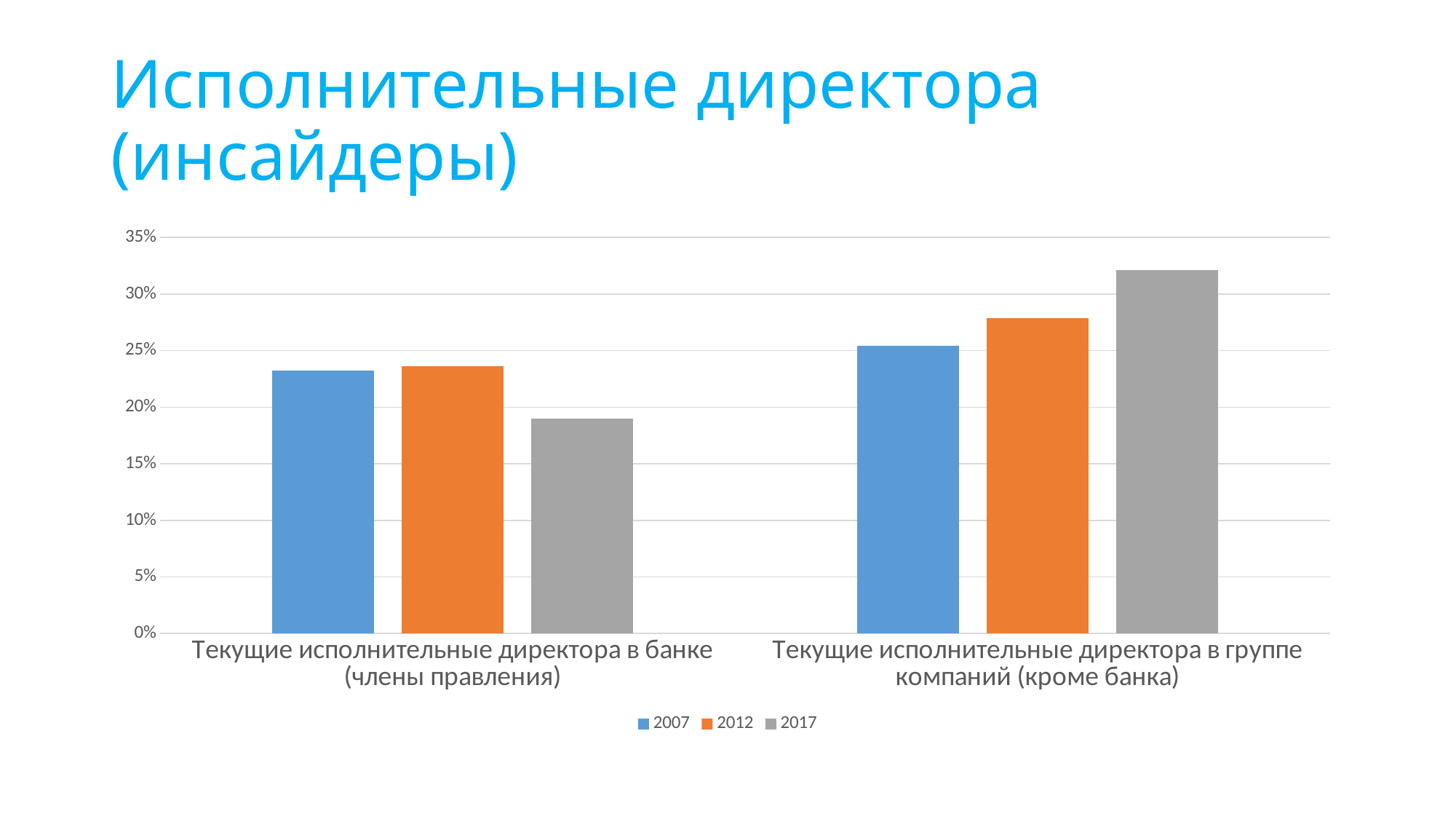
Which series has the lowest bar in the category 'Текущие исполнительные директора в банке (члены правления)'? 2017 Is the 2017 value for 'Текущие исполнительные директора в группе компаний (кроме банка)' greater or less than 30%? greater How many series does the legend list? 3 Is the 2012 value for 'Текущие исполнительные директора в группе компаний (кроме банка)' greater or less than 25%? greater Which series has the highest bar in the category 'Текущие исполнительные директора в группе компаний (кроме банка)'? 2017 Do the values for 'Текущие исполнительные директора в группе компаний (кроме банка)' rise or fall from 2007 to 2017? rise Which colour represents the 2012 series in the legend? orange What is the title of the slide? Исполнительные директора (инсайдеры) Is the 2017 value for 'Текущие исполнительные директора в банке (члены правления)' greater or less than 20%? less What kind of chart is shown on the slide? bar chart Which is larger: the 2017 value for 'Текущие исполнительные директора в банке (члены правления)' or the 2017 value for 'Текущие исполнительные директора в группе компаний (кроме банка)'? Текущие исполнительные директора в группе компаний (кроме банка) How many categories are shown on the x axis? 2